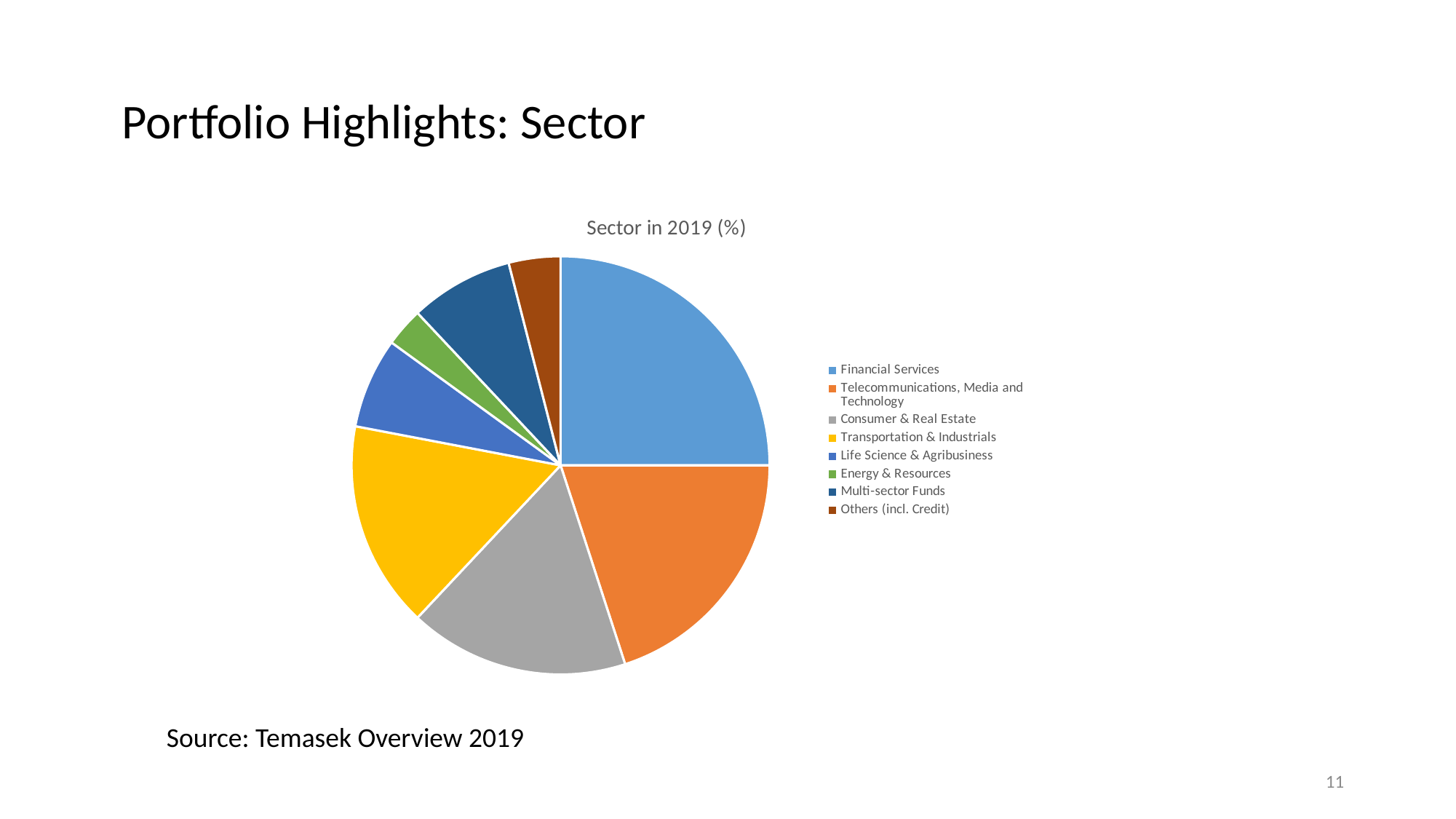
What colour is the Financial Services slice in the pie chart? Light blue What is the title of the chart? Sector in 2019 (%) Which slice is larger: Financial Services or Transportation & Industrials? Financial Services How many entries does the chart legend list? 8 What kind of chart is shown on the slide? Pie chart Which slice is larger: Multi-sector Funds or Energy & Resources? Multi-sector Funds Which sector has the smallest slice of the pie? Energy & Resources Which slice is larger: Telecommunications, Media and Technology or Life Science & Agribusiness? Telecommunications, Media and Technology How many sectors (slices) does the pie chart show? 8 Which sector has the largest slice of the pie? Financial Services